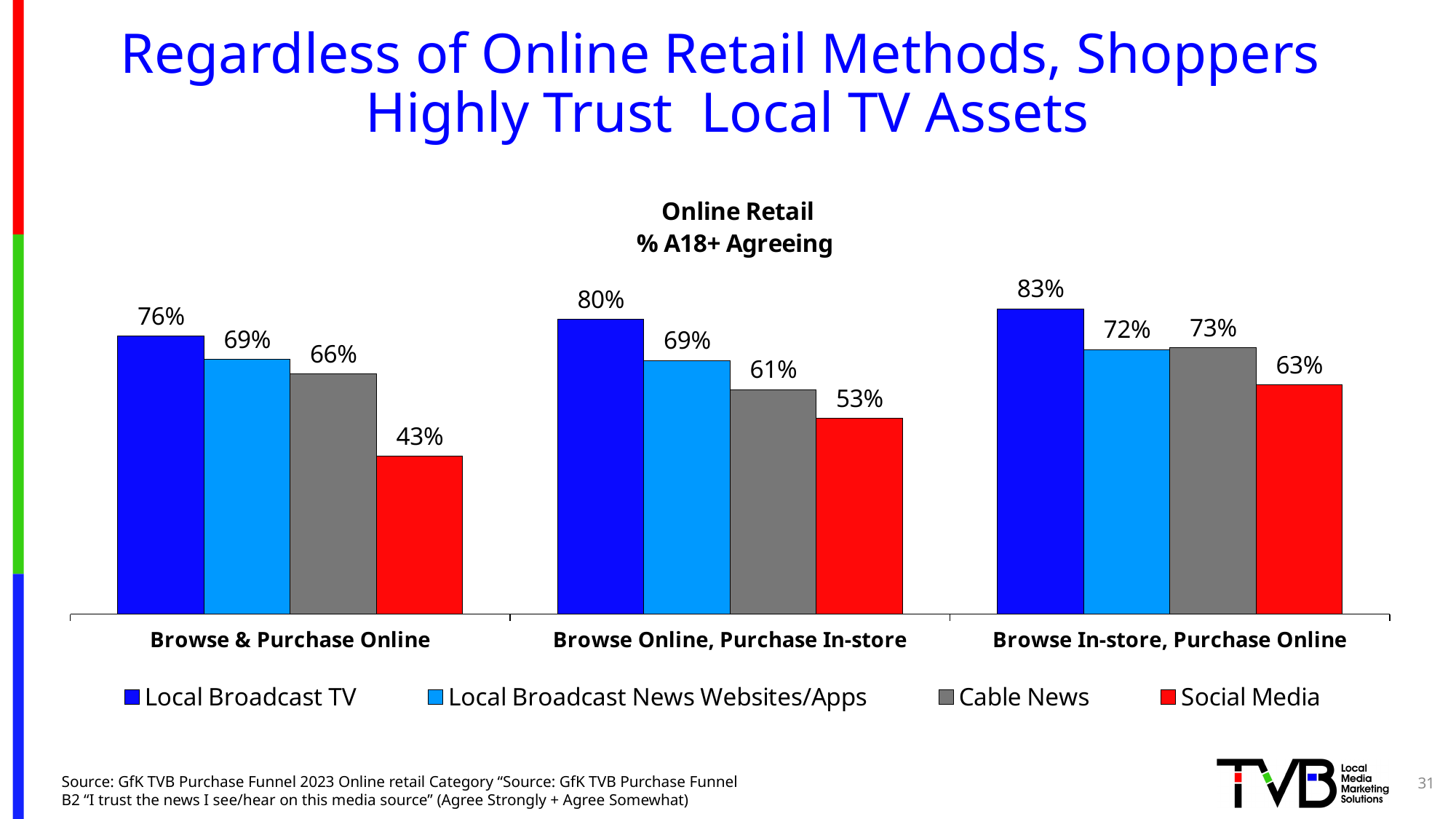
What is the value for Local Broadcast TV in the Browse & Purchase Online category? 76% Which series has the lowest value in the Browse & Purchase Online category? Social Media What is the value for Social Media in the Browse Online, Purchase In-store category? 53% What is the difference between Local Broadcast TV in Browse In-store, Purchase Online and Local Broadcast TV in Browse & Purchase Online? 7% How many categories are shown on the x axis? 3 What is the value for Cable News in the Browse In-store, Purchase Online category? 73% Which series has the highest value in the Browse In-store, Purchase Online category? Local Broadcast TV What is the difference between Local Broadcast TV and Social Media in the Browse & Purchase Online category? 33% What kind of chart is shown on the slide? Bar chart What is the title of the chart? Online Retail % A18+ Agreeing Which is larger: Cable News in Browse & Purchase Online or Cable News in Browse Online, Purchase In-store? Browse & Purchase Online How many series does the legend list? 4